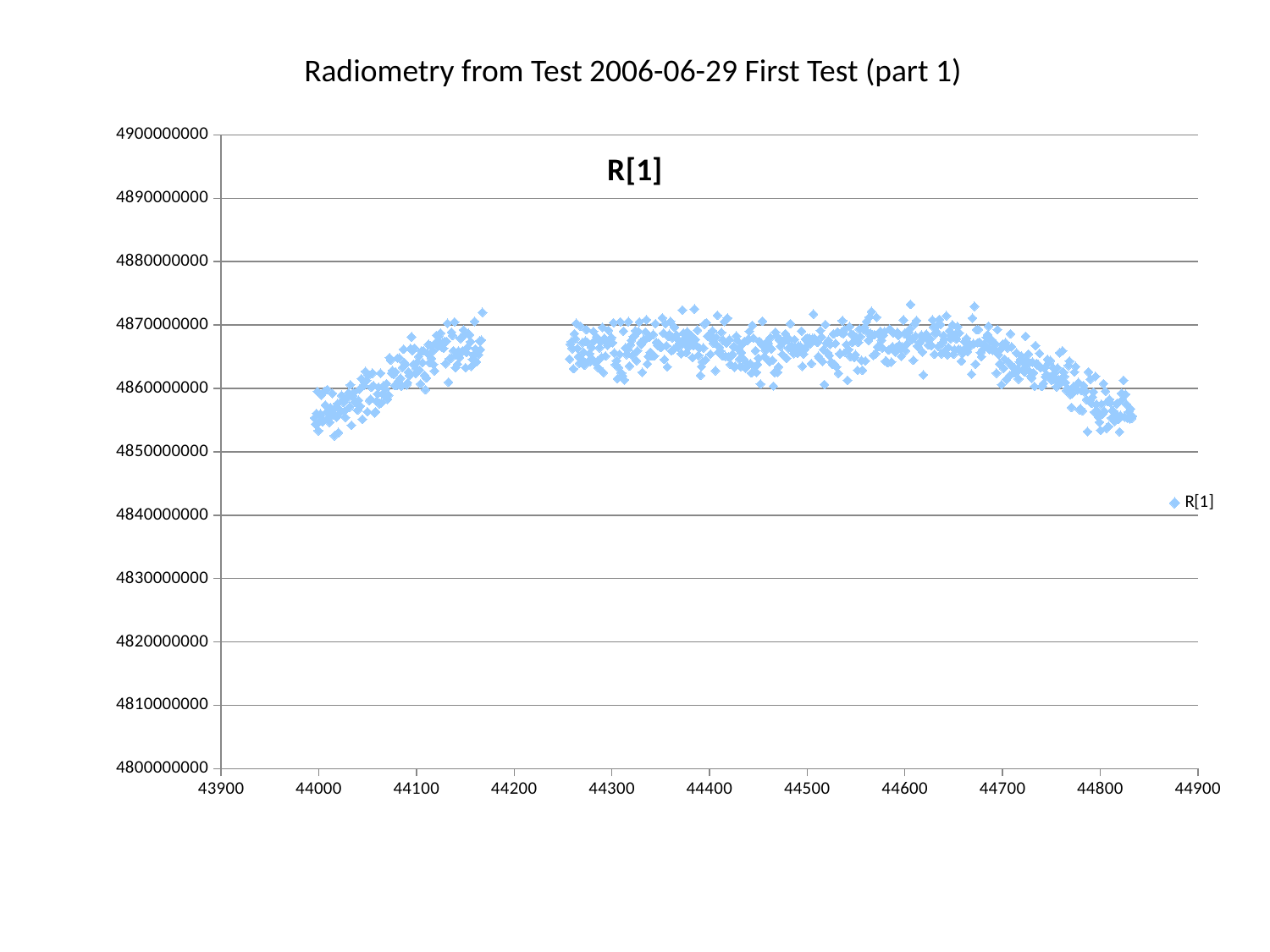
What is the title printed inside the chart area? R[1] What is the name of the series shown in the legend? R[1] Are the R[1] values near x = 44800 greater or less than 4870000000? less Are any of the plotted R[1] values greater than 4880000000? no What kind of chart is shown on the slide? scatter chart Are the R[1] values near x = 44000 greater or less than 4870000000? less How many series does the legend list? 1 What is the lowest value shown on the y axis? 4800000000 Which x-axis region has higher R[1] values: around 44000 or around 44500? around 44500 Do the R[1] values rise or fall as x increases from 44700 to 44830? fall Do the R[1] values rise or fall as x increases from 44000 to 44150? rise